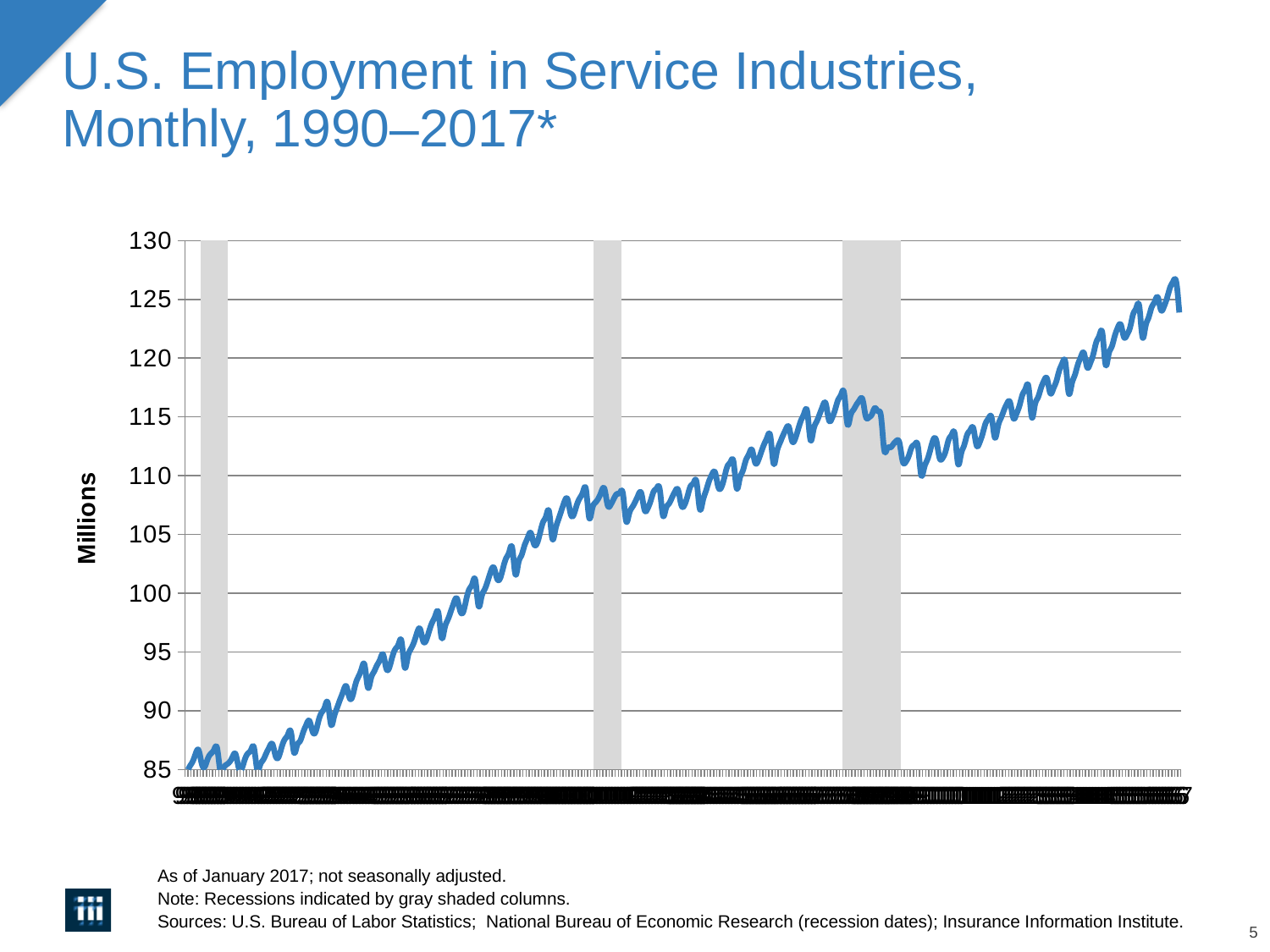
Which is larger: the value at the left end of the line or the value at the right end of the line? the right end What is the label on the vertical axis of the chart? Millions Is the value at the start of the series (left end of the line) greater or less than 90? less Is the peak of the line just before the third gray shaded column greater or less than 110? greater Is the highest point of the line greater or less than 120? greater Do the values in the chart generally rise or fall from left to right along the x axis? rise How many gray shaded columns (recessions) are shown on the chart? 3 Where along the x axis does the line reach its highest value: near the start, in the middle, or near the end? near the end What kind of chart is shown on the slide? line chart